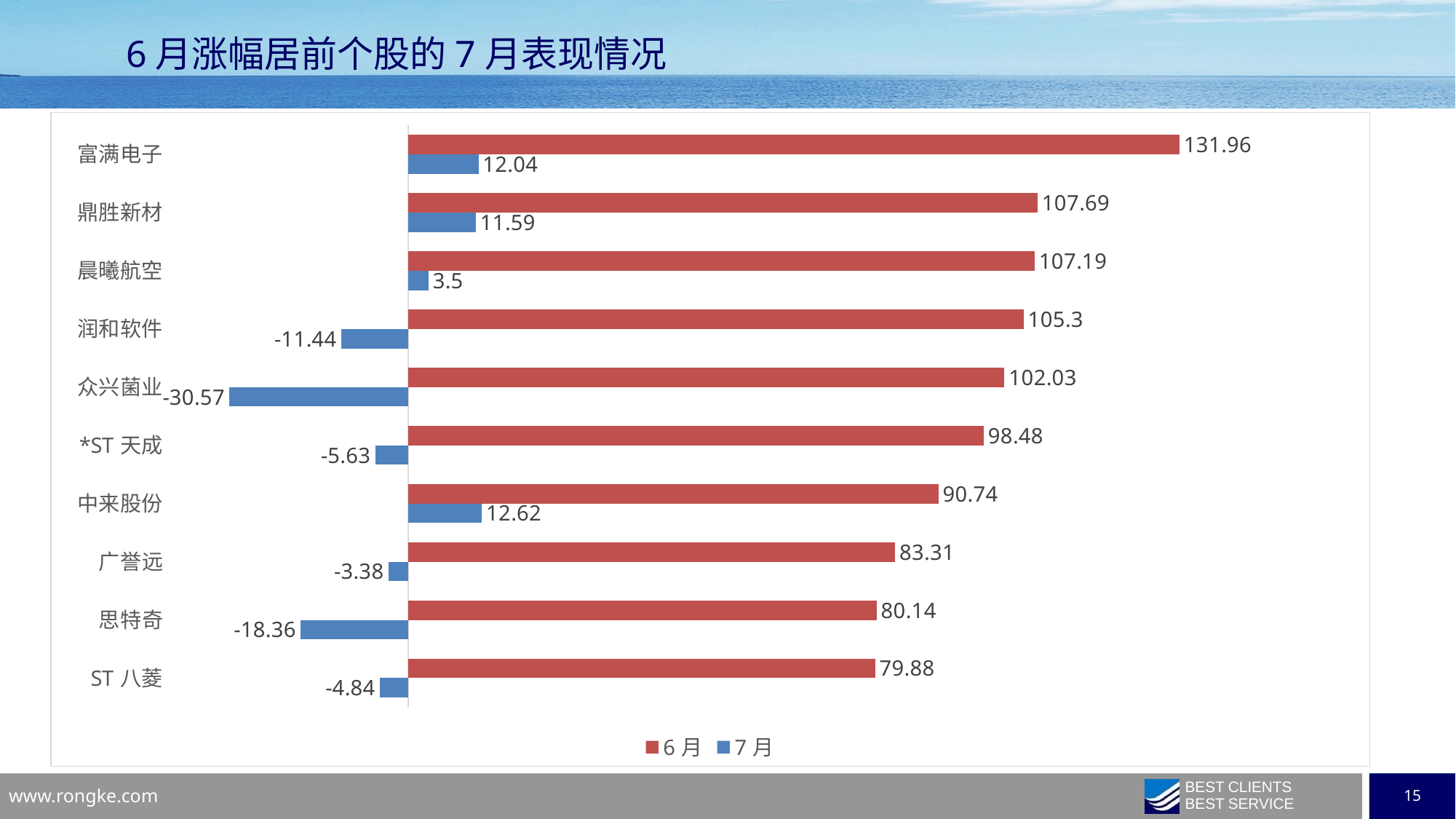
How many stocks are shown in the chart? 10 Which colour represents the 7月 series in the chart? Blue Which stock has the highest 6月 value? 富满电子 What kind of chart is shown on the slide? Bar chart What is the 7月 value for 众兴菌业? -30.57 What is the 6月 value for 富满电子? 131.96 Which stock has the lowest 7月 value? 众兴菌业 How many series does the legend list? 2 What is the difference between the 6月 and 7月 values for 富满电子? 119.92 Which stock has the highest 7月 value? 中来股份 Which is larger, the 6月 value for 鼎胜新材 or the 6月 value for 晨曦航空? 鼎胜新材 What is the 7月 value for 晨曦航空? 3.5